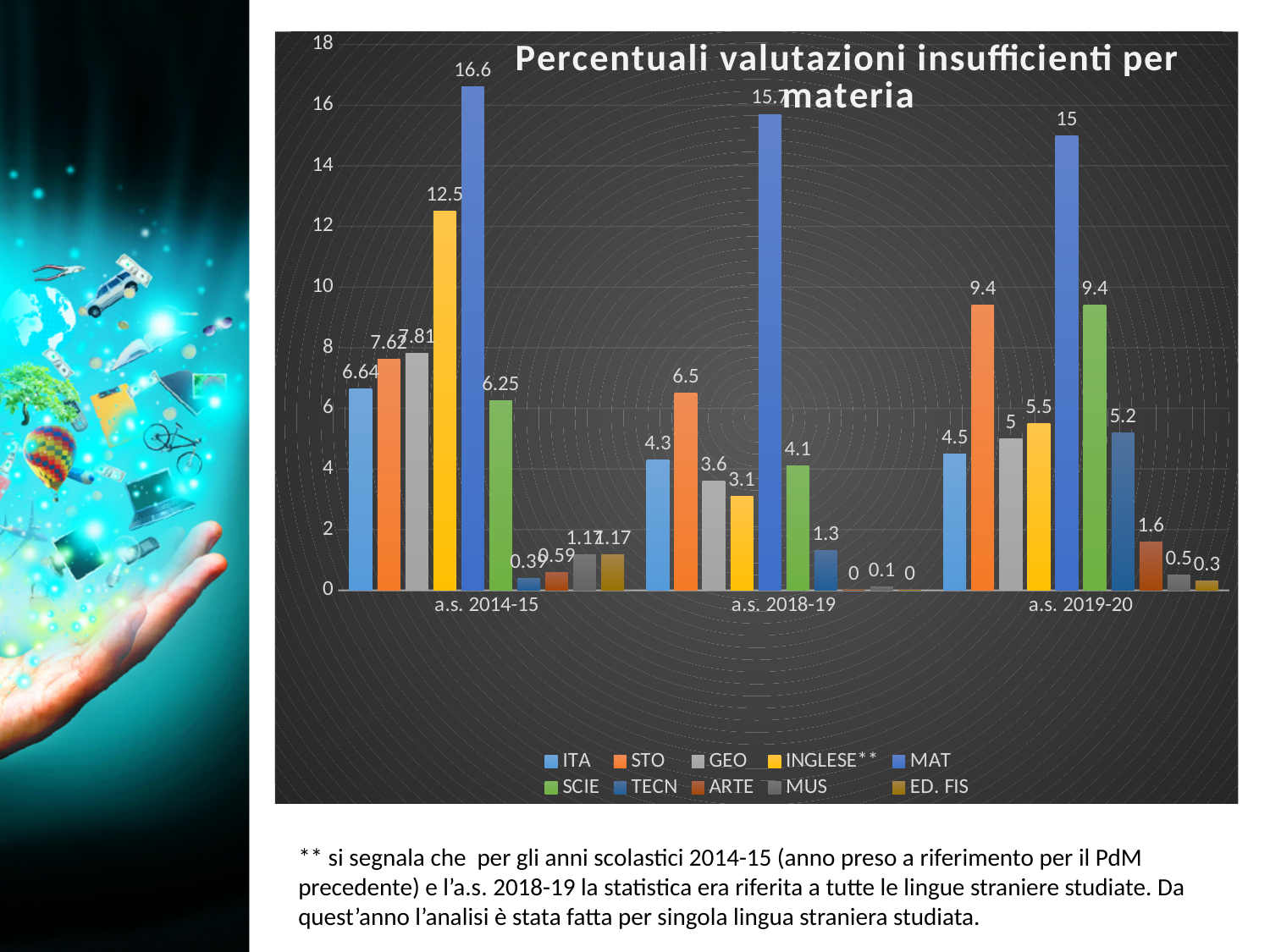
What is the value for ITA in a.s. 2018-19? 4.3 What is the value for STO in a.s. 2019-20? 9.4 In which school year is the value for MAT the highest? a.s. 2014-15 How many series does the legend list? 10 Does the value for MAT rise or fall from a.s. 2014-15 to a.s. 2019-20? fall Which is larger, the ITA value in a.s. 2014-15 or the ITA value in a.s. 2019-20? a.s. 2014-15 What kind of chart is shown on the slide? bar chart What is the difference between the MAT value in a.s. 2014-15 and the MAT value in a.s. 2019-20? 1.6 Which subject has the highest value in a.s. 2019-20? MAT How many school years are shown on the x axis? 3 What is the value for MAT in a.s. 2014-15? 16.6 What is the value for INGLESE** in a.s. 2014-15? 12.5